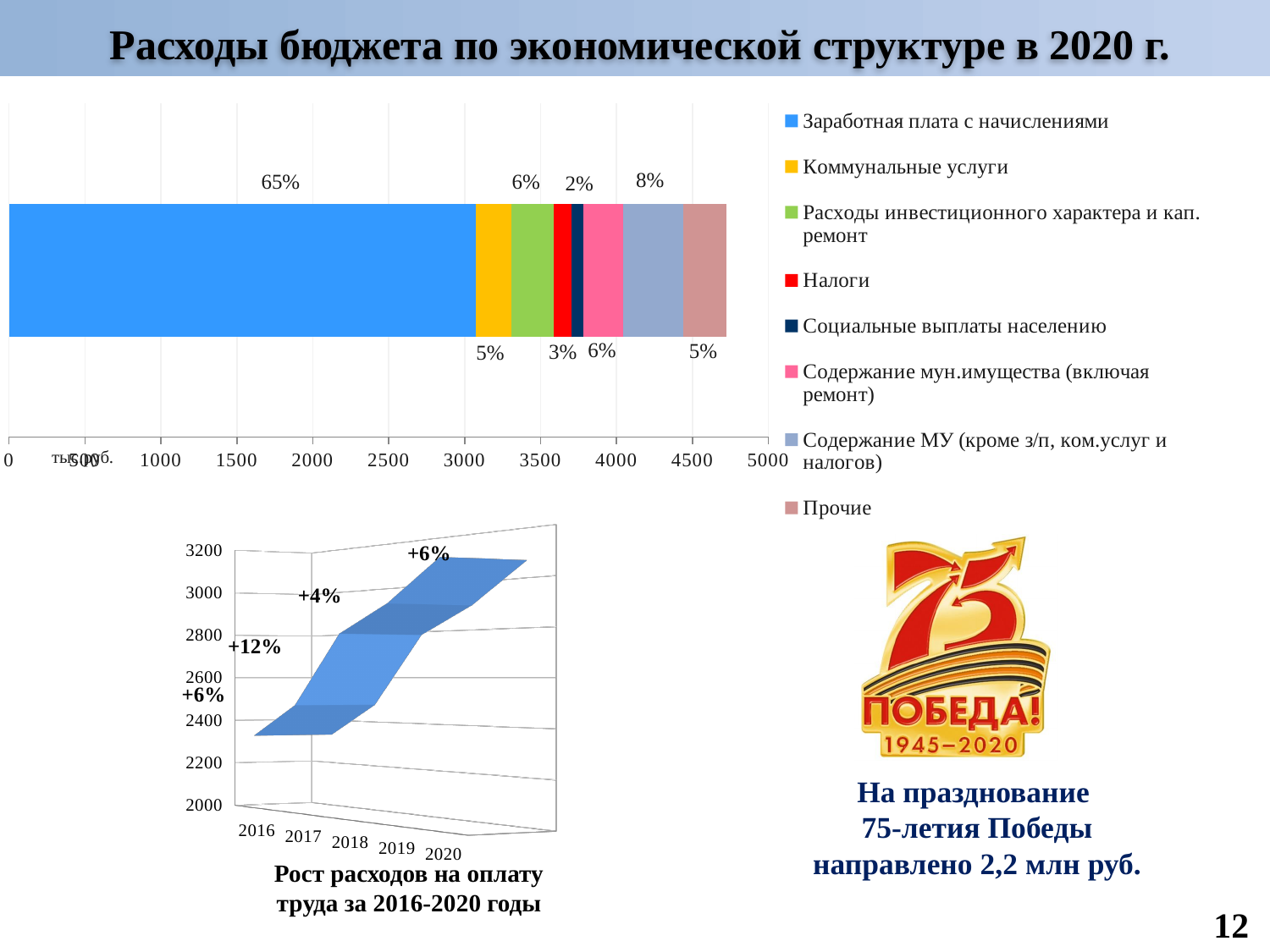
In the bottom-left chart 'Рост расходов на оплату труда за 2016-2020 годы', do the values rise or fall from 2016 to 2020? rise In the top stacked bar chart, which category has the largest share? Заработная плата с начислениями In the top stacked bar chart, what share is shown for Налоги? 3% In the top stacked bar chart, what share is shown for Содержание МУ (кроме з/п, ком.услуг и налогов)? 8% In the top stacked bar chart, what share is shown for Заработная плата с начислениями? 65% In the top stacked bar chart, which category has the smallest share? Социальные выплаты населению In the top stacked bar chart, what is the difference between the shares for Заработная плата с начислениями and Содержание МУ (кроме з/п, ком.услуг и налогов)? 57% In the bottom-left chart 'Рост расходов на оплату труда за 2016-2020 годы', is the value for 2020 greater or less than 3000? greater How many entries does the legend of the top stacked bar chart list? 8 In the top stacked bar chart, which is larger: the share for Налоги or the share for Коммунальные услуги? Коммунальные услуги What kind of chart is the bottom-left chart titled 'Рост расходов на оплату труда за 2016-2020 годы'? line chart (3D line chart) In the top stacked bar chart, what share is shown for Социальные выплаты населению? 2%